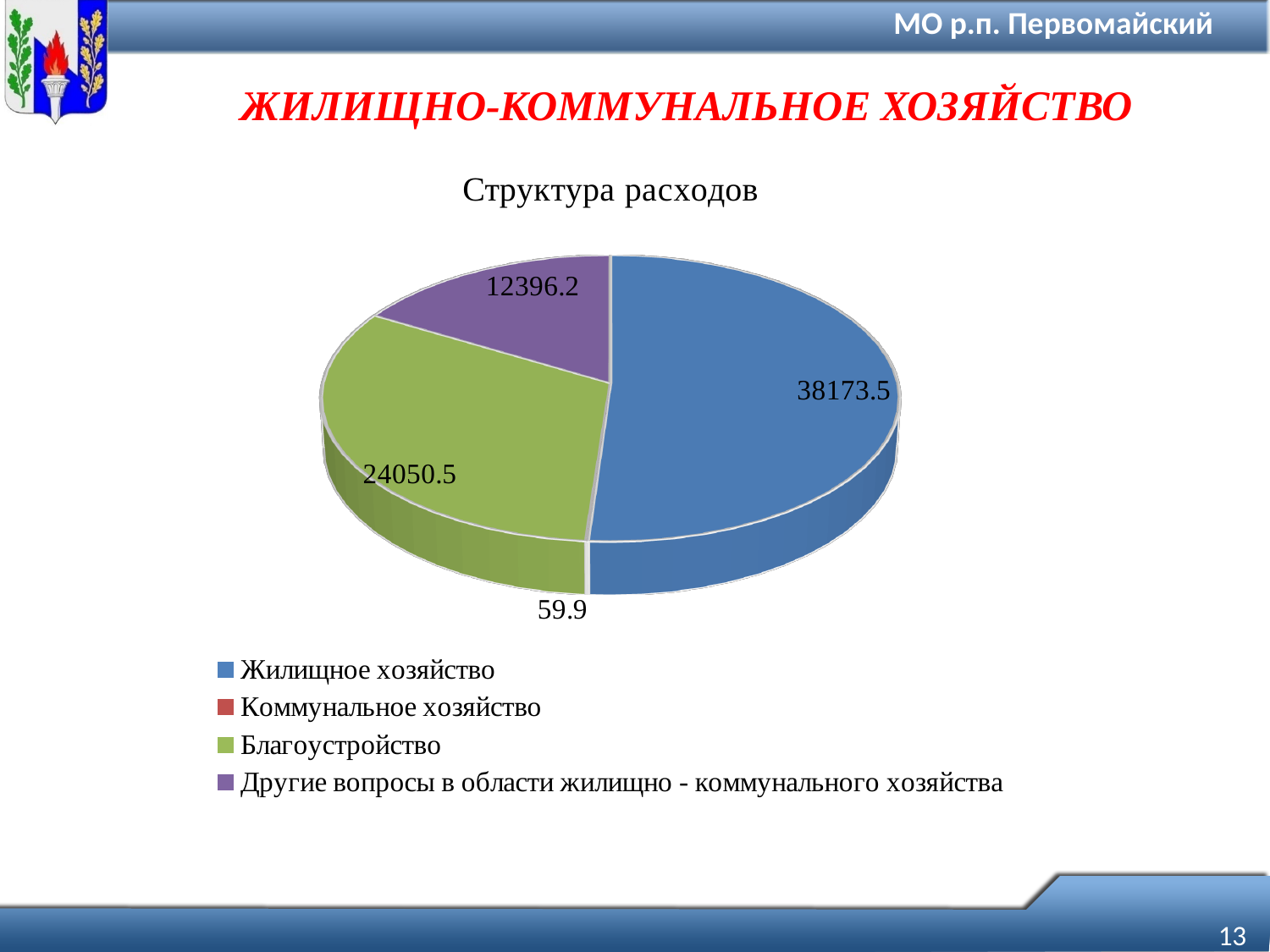
What is the title of the chart? Структура расходов Which category has the smallest slice of the pie? Коммунальное хозяйство What is the value for Коммунальное хозяйство in the pie chart? 59.9 What is the value for Жилищное хозяйство in the pie chart? 38173.5 What is the value for Благоустройство in the pie chart? 24050.5 What is the difference between the values for Благоустройство and Другие вопросы в области жилищно - коммунального хозяйства? 11654.3 How many categories are shown in the pie chart? 4 Which is larger, the value for Благоустройство or the value for Другие вопросы в области жилищно - коммунального хозяйства? Благоустройство What is the value for Другие вопросы в области жилищно - коммунального хозяйства? 12396.2 What is the difference between the values for Жилищное хозяйство and Благоустройство? 14123.0 Which category has the largest slice of the pie? Жилищное хозяйство What kind of chart is shown on the slide? Pie chart